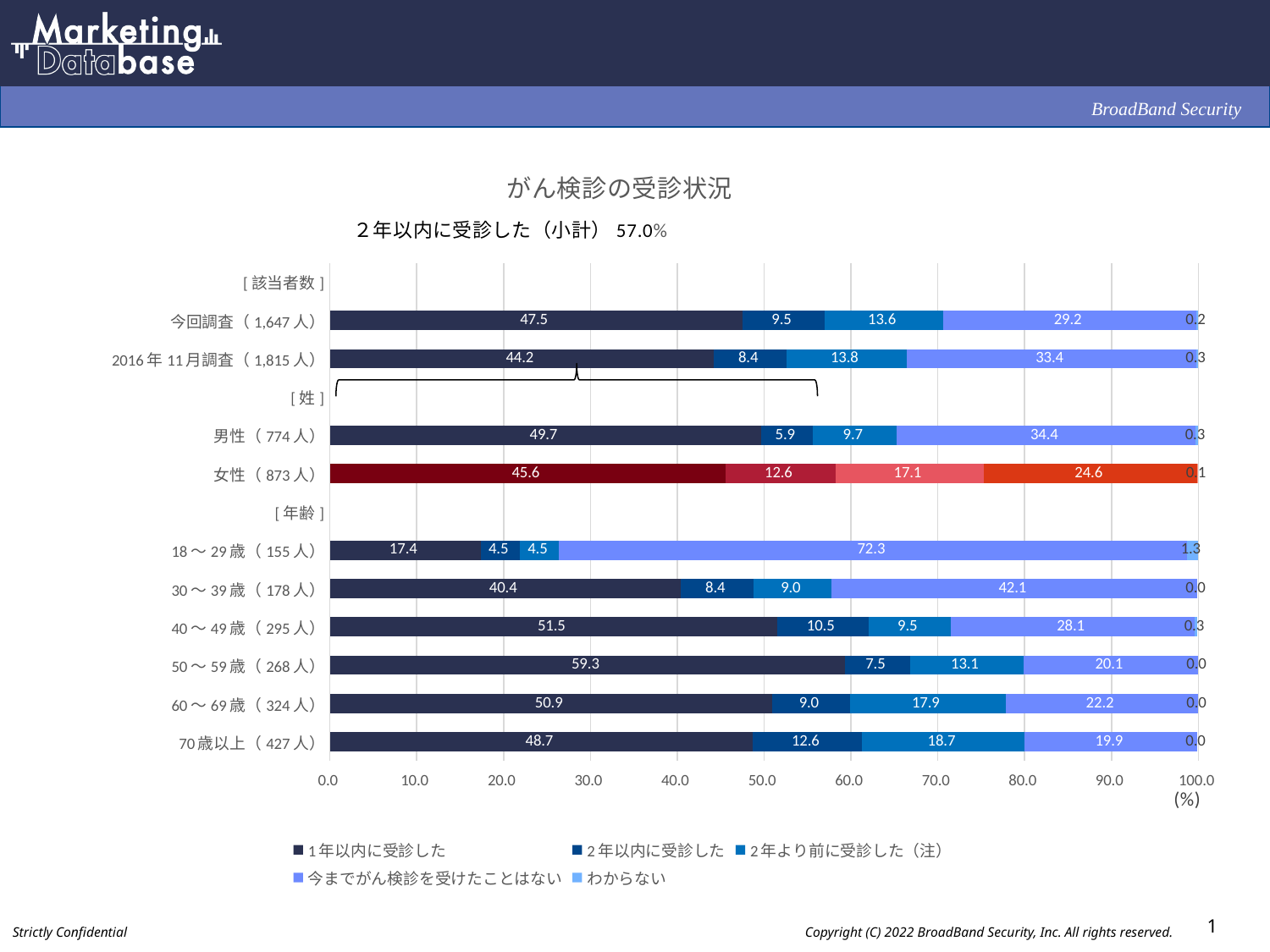
How many categories have data bars in the chart? 10 What is the value of 今までがん検診を受けたことはない for 18～29歳 (155人)? 72.3 What is the difference between the 1年以内に受診した values for 男性 (774人) and 女性 (873人)? 4.1 Which category has the highest value for 1年以内に受診した? 50～59歳 (268人) What type of chart is shown on the slide? Stacked bar chart Which category has the lowest value for 1年以内に受診した? 18～29歳 (155人) Which has a larger value for 2年以内に受診した: 男性 (774人) or 女性 (873人)? 女性 (873人) What is the value of 2年より前に受診した（注） for 女性 (873人)? 17.1 What is the title of the chart? がん検診の受診状況 How many series does the legend list? 5 What is the value of 1年以内に受診した for 今回調査 (1,647人)? 47.5 What is the total of the stacked bar for 今回調査 (1,647人)? 100.0